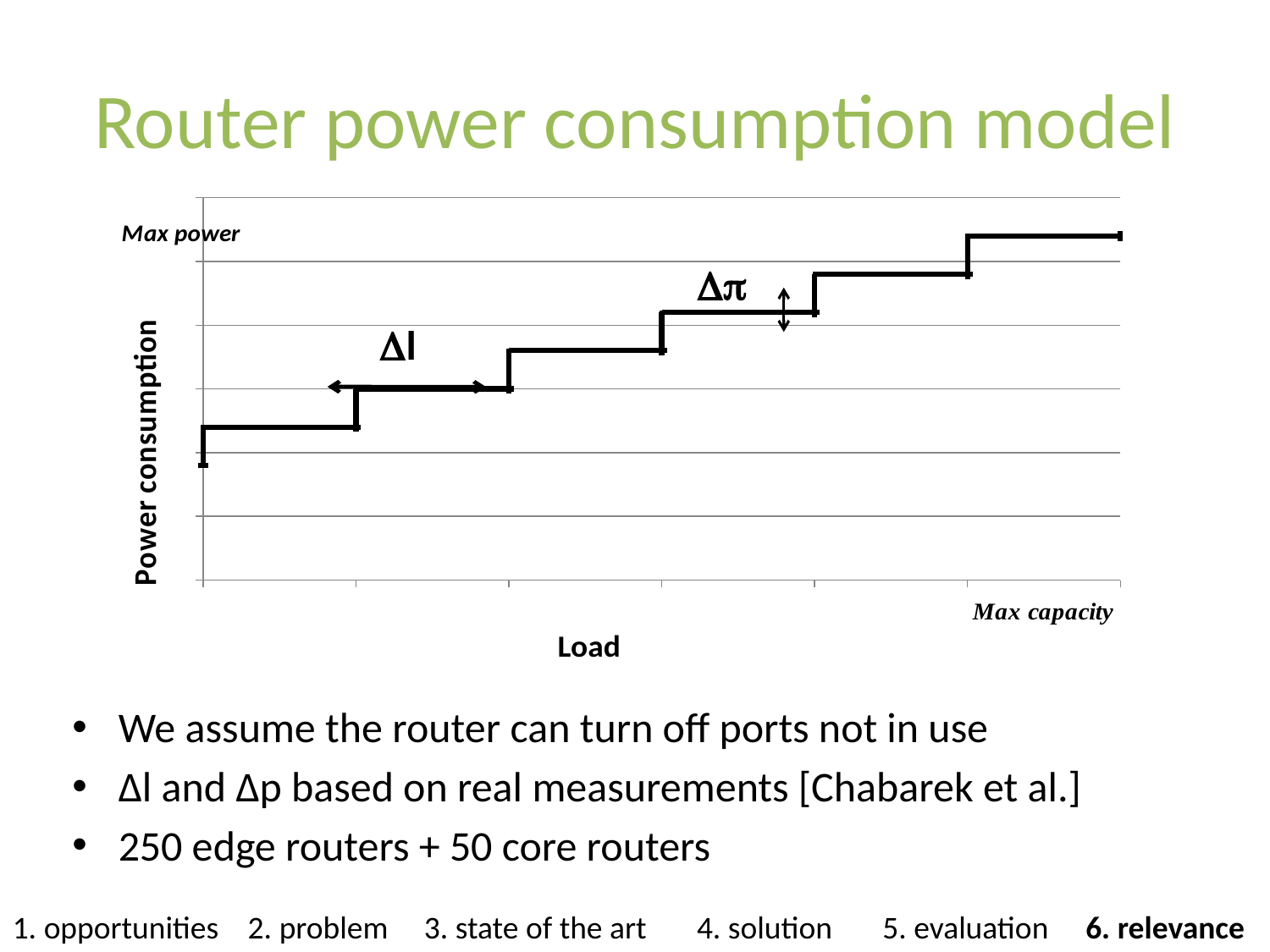
Is the power consumption at Max capacity higher or lower than at zero load? higher Does power consumption rise or fall as load increases along the x axis? rise What is the label of the x axis? Load How many lines are plotted on the chart? 1 What kind of chart is shown on the slide? line chart How many horizontal steps (plateaus) does the plotted line have? 6 Which annotation on the chart marks the horizontal width of a step? Δl